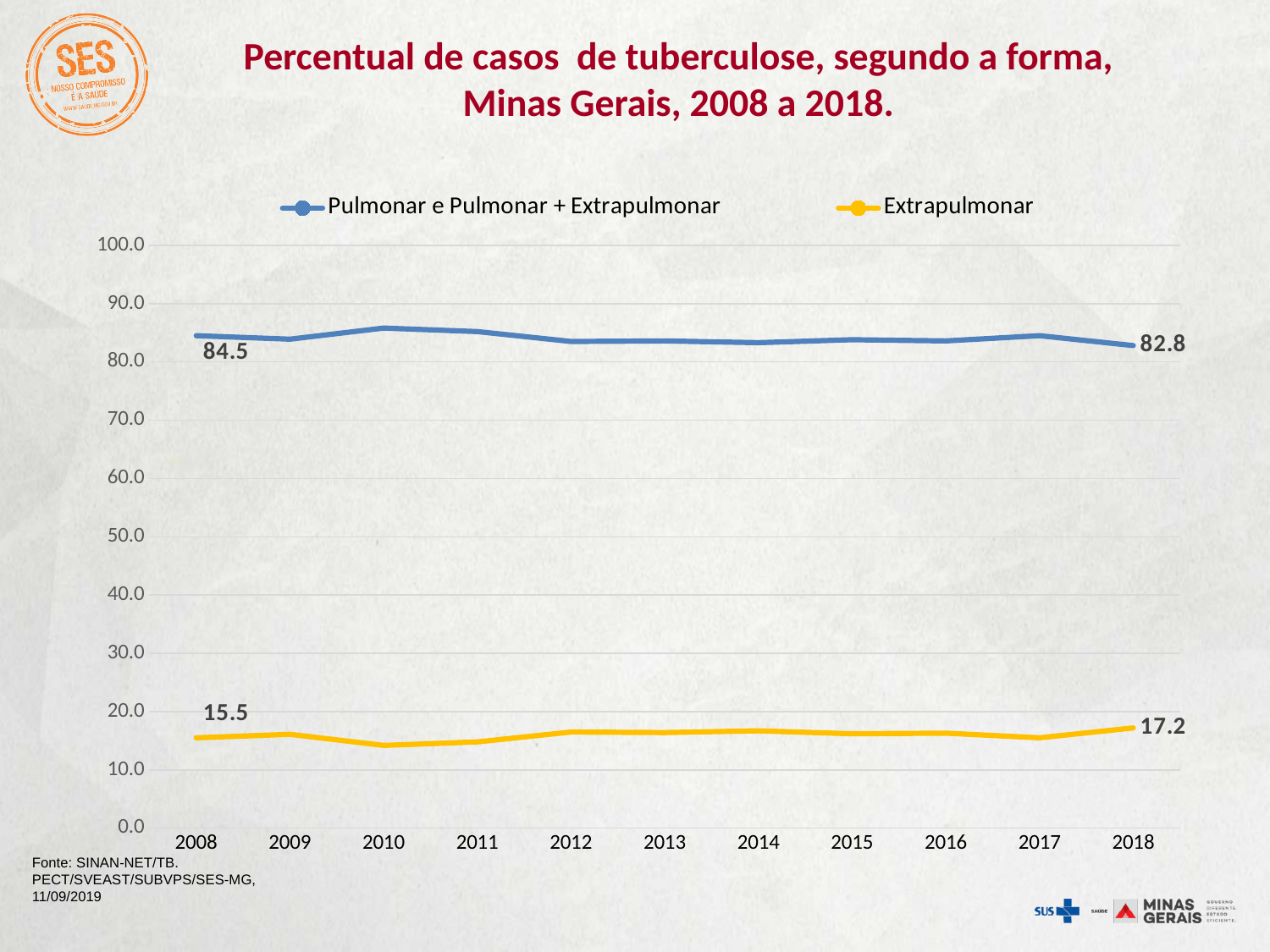
By how much did the Extrapulmonar value increase from 2008 to 2018? 1.7 By how much did the Pulmonar e Pulmonar + Extrapulmonar value decrease from 2008 to 2018? 1.7 What is the value for Pulmonar e Pulmonar + Extrapulmonar in 2008? 84.5 What is the value for Extrapulmonar in 2008? 15.5 How many series does the legend list? 2 Is the value for Extrapulmonar in 2010 greater or less than 20.0? less What is the value for Pulmonar e Pulmonar + Extrapulmonar in 2018? 82.8 What is the value for Extrapulmonar in 2018? 17.2 In 2018, which series has the larger value, Pulmonar e Pulmonar + Extrapulmonar or Extrapulmonar? Pulmonar e Pulmonar + Extrapulmonar Is the value for Pulmonar e Pulmonar + Extrapulmonar in 2010 greater or less than 80.0? greater What kind of chart is shown on the slide? line chart How many years are shown on the x axis? 11